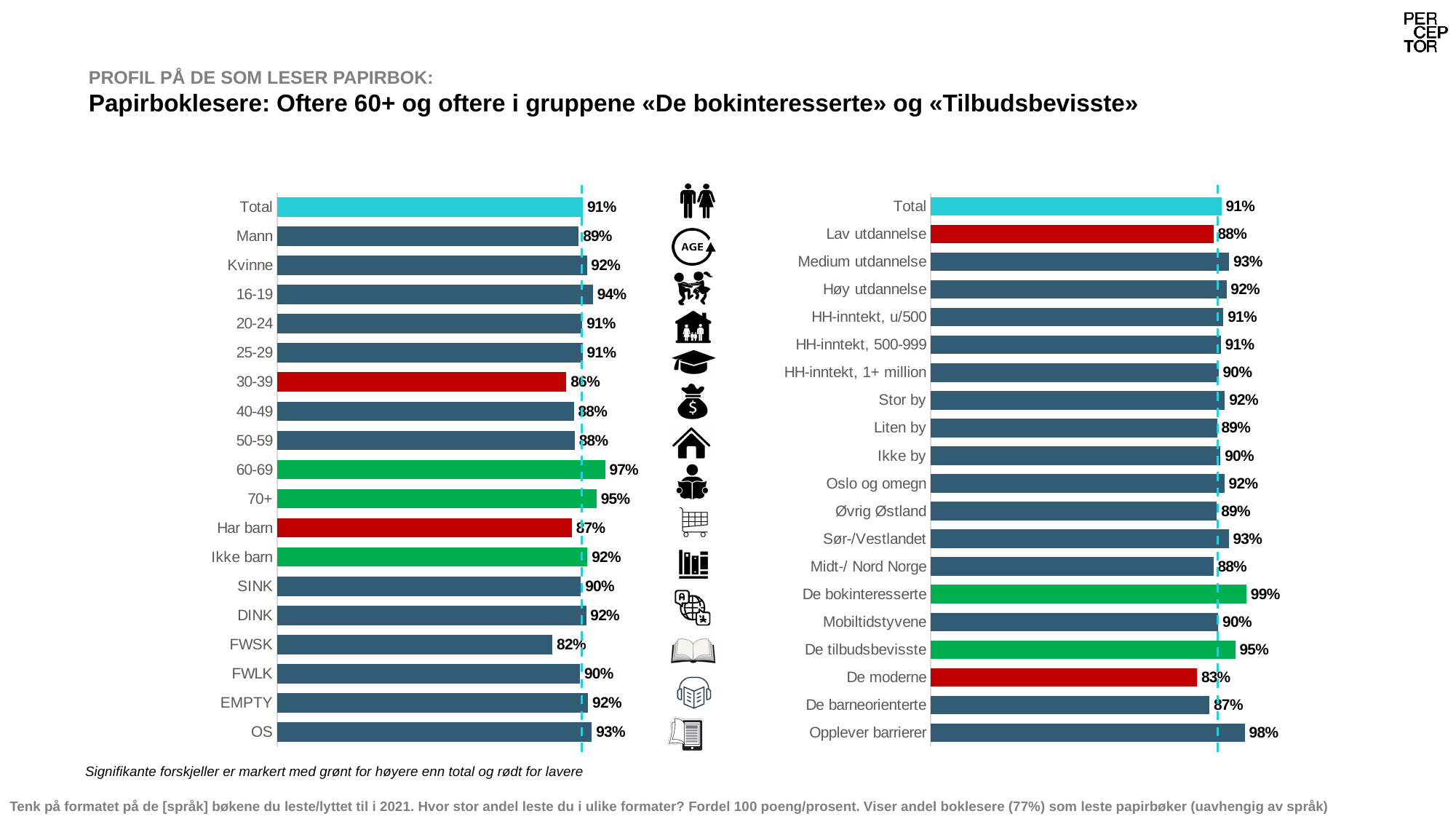
How many categories are shown in the right chart? 20 In the right chart, what is the value for De moderne? 83% In the left chart, what is the value for FWSK? 82% In the left chart, which category has the lowest value? FWSK In the right chart, what is the value for De bokinteresserte? 99% In the right chart, what is the difference between De bokinteresserte and De moderne? 16% What kind of chart is the left chart? Bar chart In the left chart, which is larger, the value for 16-19 or the value for 30-39? 16-19 In the left chart, which category has the highest value? 60-69 In the left chart, what colour is the bar for Har barn? Red In the left chart, what is the value for 60-69? 97% In the right chart, which category has the lowest value? De moderne